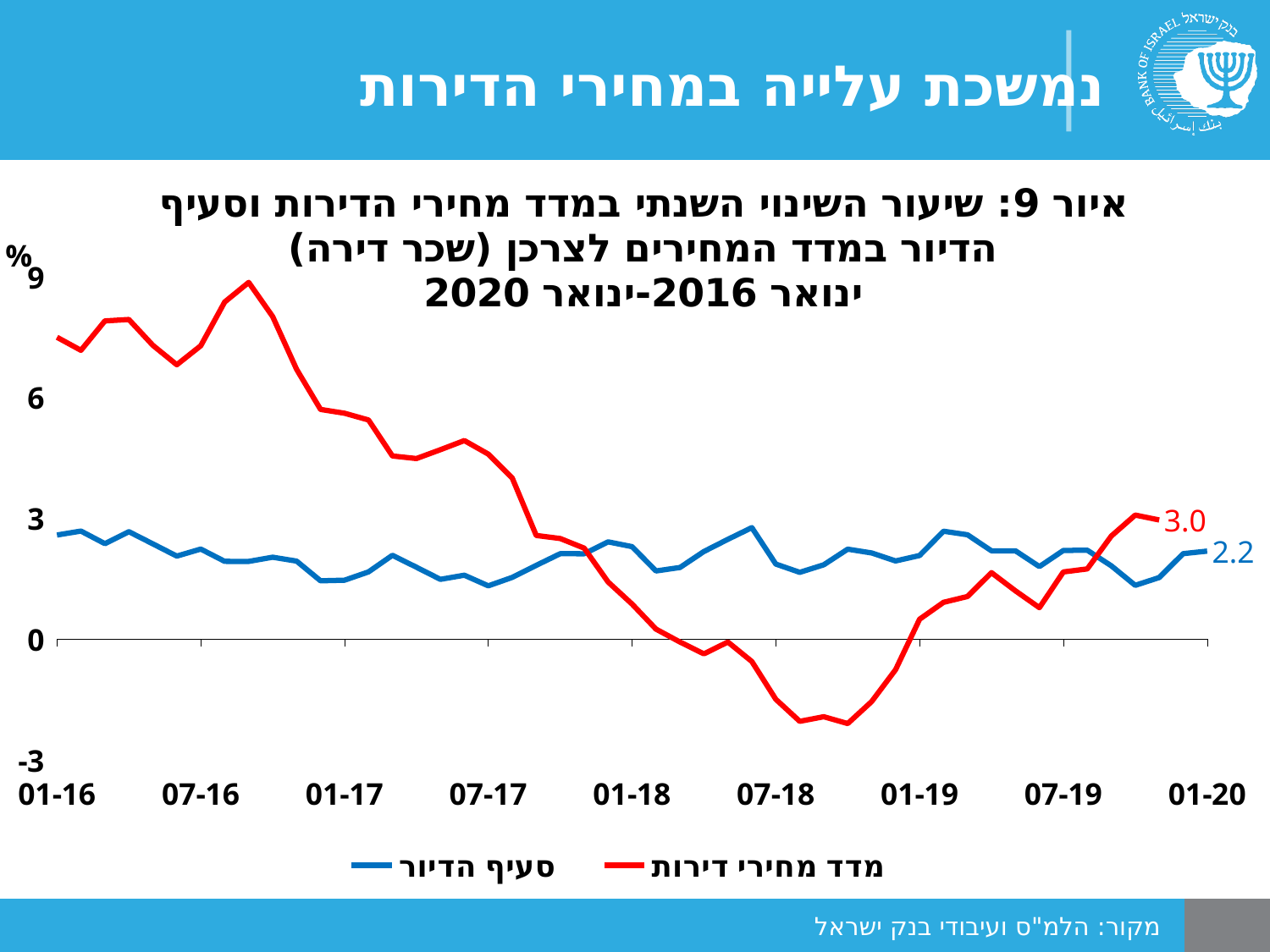
Which colour represents the series סעיף הדיור in the legend? blue Does the מדד מחירי דירות (red line) rise or fall between 07-18 and 01-20? rise Is the value of סעיף הדיור (blue line) at 01-16 greater or less than 3? less What is the difference between the final labelled values of מדד מחירי דירות (3.0) and סעיף הדיור (2.2)? 0.8 Does the מדד מחירי דירות (red line) rise or fall between 01-16 and 07-18? fall Is the value of מדד מחירי דירות (red line) at 01-16 greater or less than 6? greater Is the value of מדד מחירי דירות (red line) around 07-18 greater or less than 0? less What is the final value shown for the series מדד מחירי דירות (red line) at 01-20? 3.0 What kind of chart is shown on the slide? line chart At the end of the period (01-20), which series has the higher value: מדד מחירי דירות or סעיף הדיור? מדד מחירי דירות What is the final value shown for the series סעיף הדיור (blue line) at 01-20? 2.2 How many series does the legend list? 2